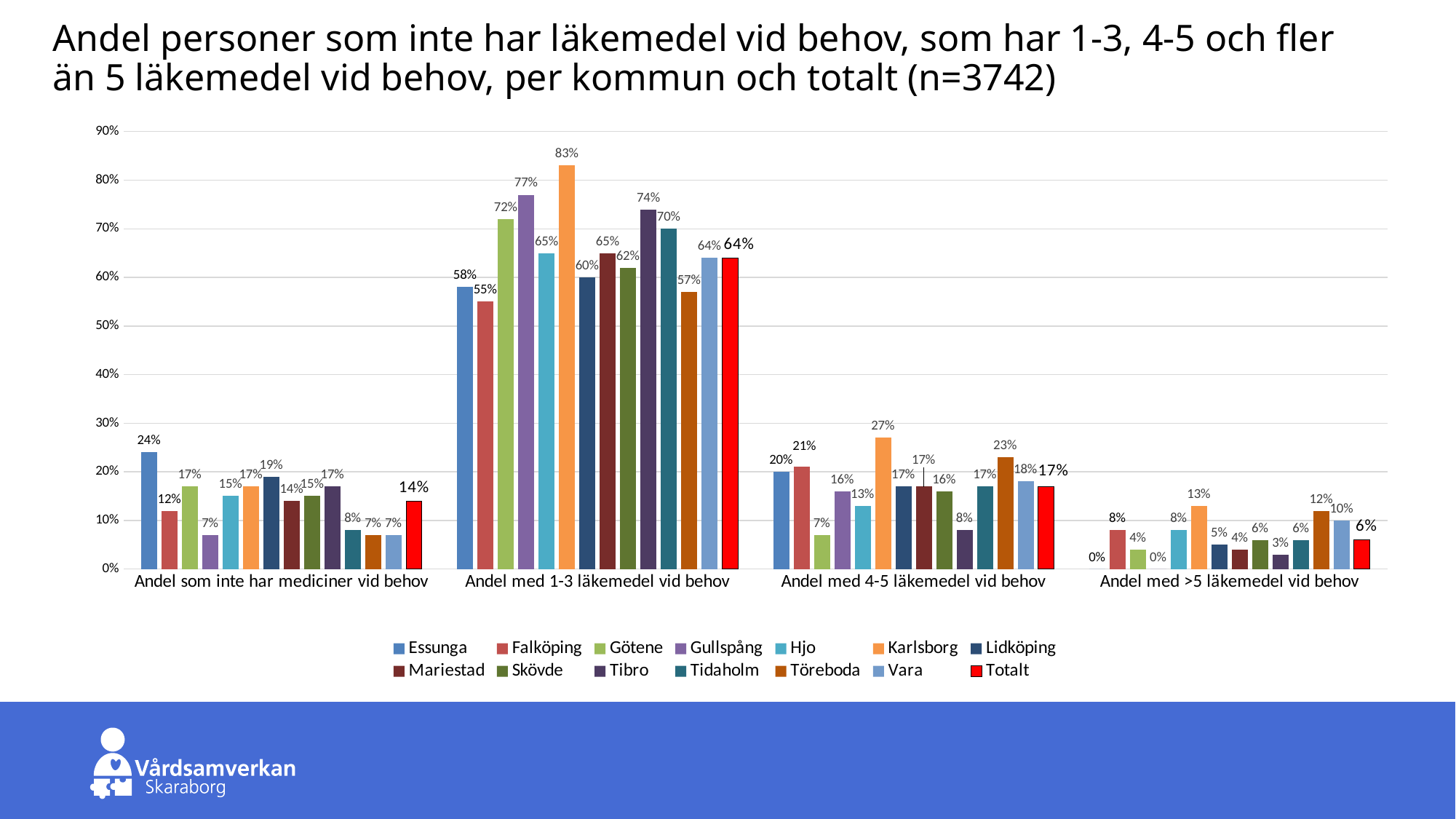
What colour is the Totalt series in the legend? red How many categories are shown on the x axis? 4 What is the value for Karlsborg in the category "Andel med 1-3 läkemedel vid behov"? 83% What is the difference between Karlsborg and Essunga in the category "Andel med 1-3 läkemedel vid behov"? 25% What kind of chart is shown on the slide? bar chart What is the value for Töreboda in the category "Andel med 4-5 läkemedel vid behov"? 23% Which municipality has the highest value in the category "Andel som inte har mediciner vid behov"? Essunga Which series has the lowest value in the category "Andel med 1-3 läkemedel vid behov"? Falköping How many series does the legend list? 14 What is the Totalt value in the category "Andel som inte har mediciner vid behov"? 14% In the category "Andel med 4-5 läkemedel vid behov", which is larger: Falköping or Essunga? Falköping Is the value for Gullspång in the category "Andel med 1-3 läkemedel vid behov" greater or less than 70%? greater